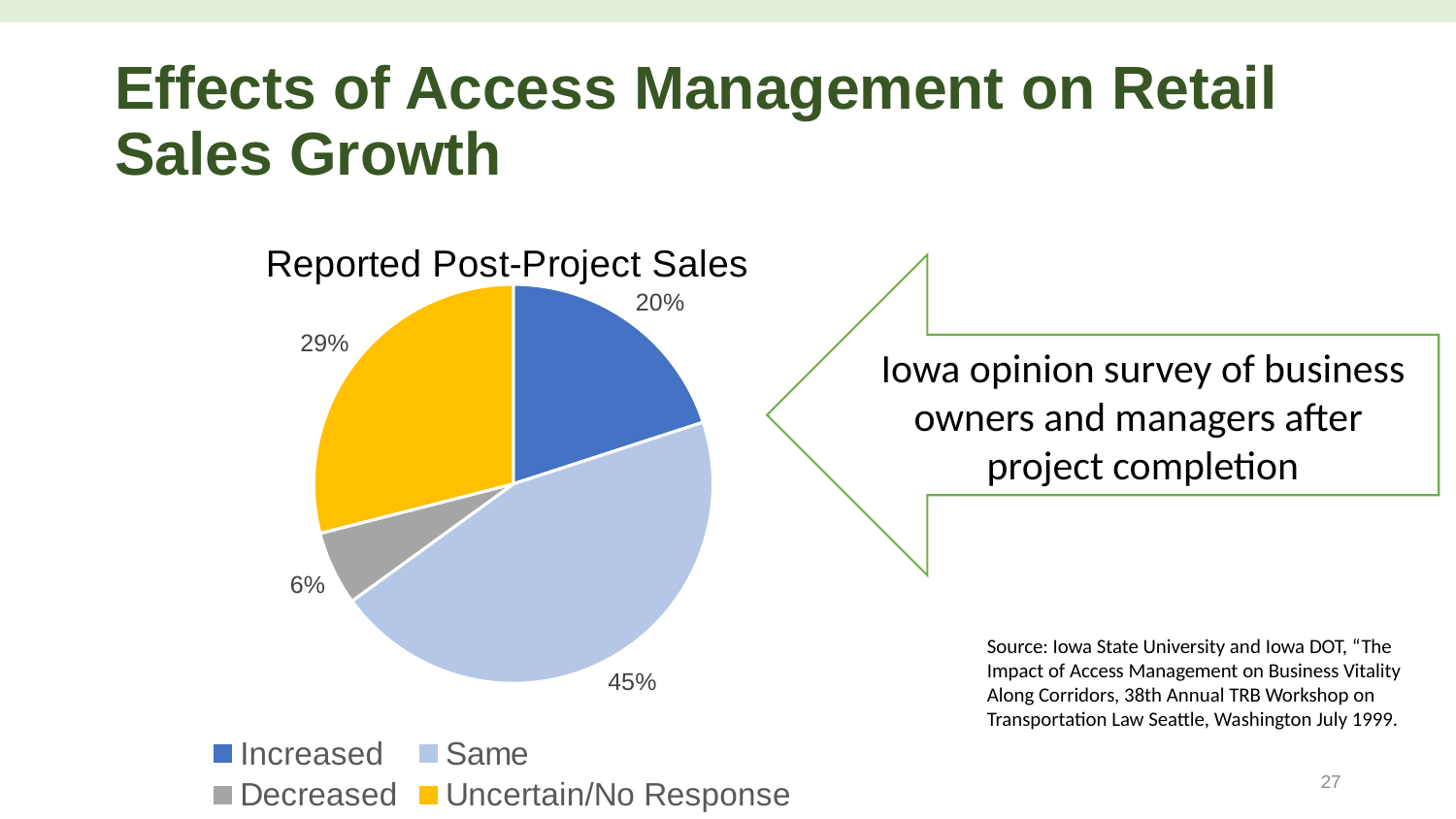
What kind of chart is shown on the slide? pie chart What colour is the Uncertain/No Response slice? yellow What is the difference in percentage points between Same and Increased? 25 What percentage of respondents were Uncertain/No Response? 29% How many categories does the pie chart have? 4 What percentage of respondents reported sales as Same? 45% Which category has the largest share of the pie? Same What percentage of respondents reported sales Decreased? 6% What percentage of respondents reported sales Increased? 20% Which category has the smallest share of the pie? Decreased Which is larger, the share for Increased or the share for Uncertain/No Response? Uncertain/No Response What is the title of the chart? Reported Post-Project Sales